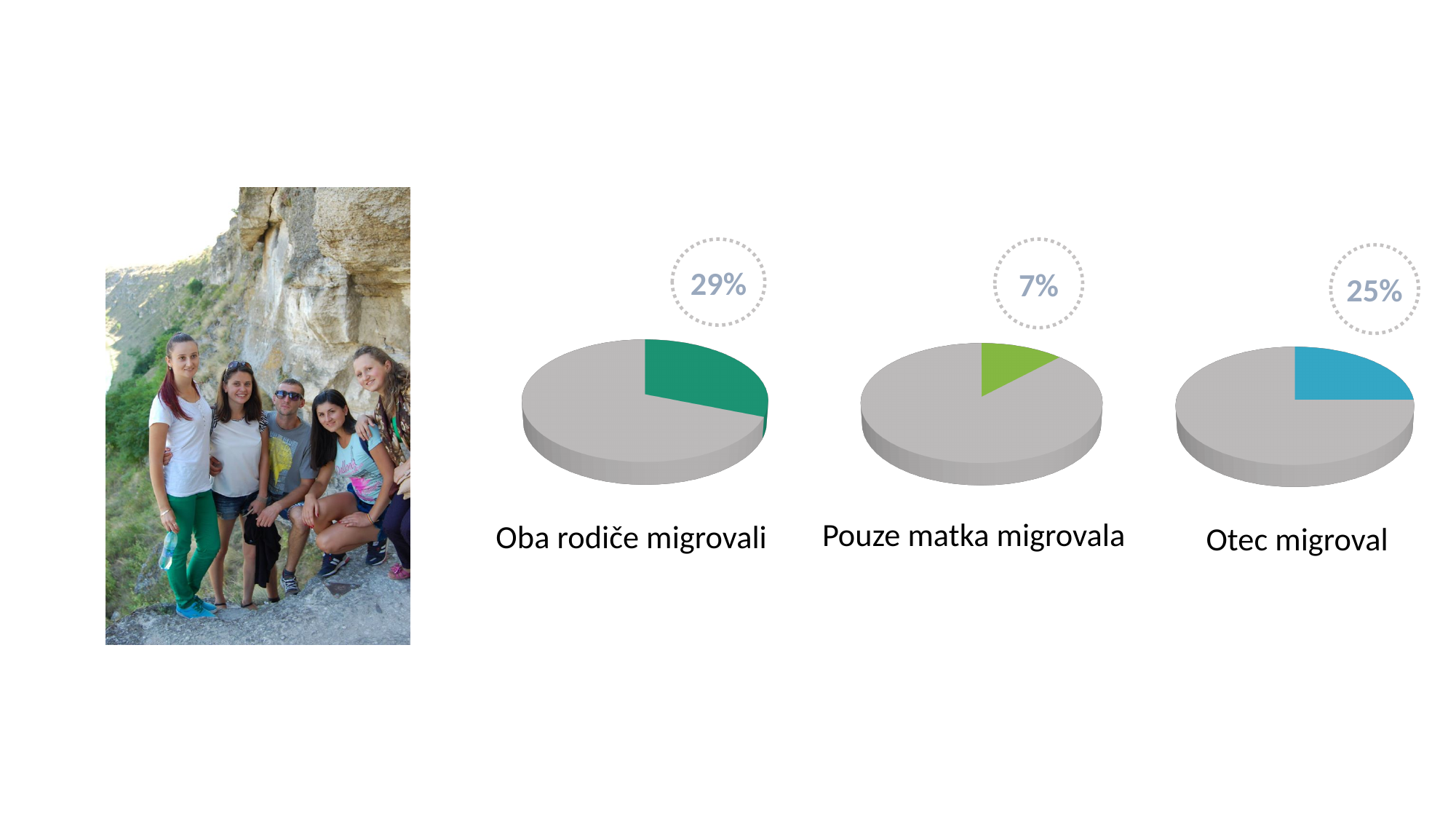
Which is larger, the percentage for 'Oba rodiče migrovali' or for 'Pouze matka migrovala'? Oba rodiče migrovali Which of the three pie charts shows the lowest percentage? Pouze matka migrovala What colour is the highlighted slice in the 'Otec migroval' pie chart? Blue What colour is the highlighted slice in the 'Pouze matka migrovala' pie chart? Green What kind of chart is used for 'Otec migroval'? Pie chart How many pie charts are on the slide? 3 What is the difference between the percentages shown for 'Otec migroval' and 'Pouze matka migrovala'? 18% What percentage is shown for the 'Otec migroval' pie chart? 25% Which of the three pie charts shows the highest percentage? Oba rodiče migrovali What percentage is shown for the 'Oba rodiče migrovali' pie chart? 29% What percentage is shown for the 'Pouze matka migrovala' pie chart? 7% What is the difference between the percentages shown for 'Oba rodiče migrovali' and 'Otec migroval'? 4%